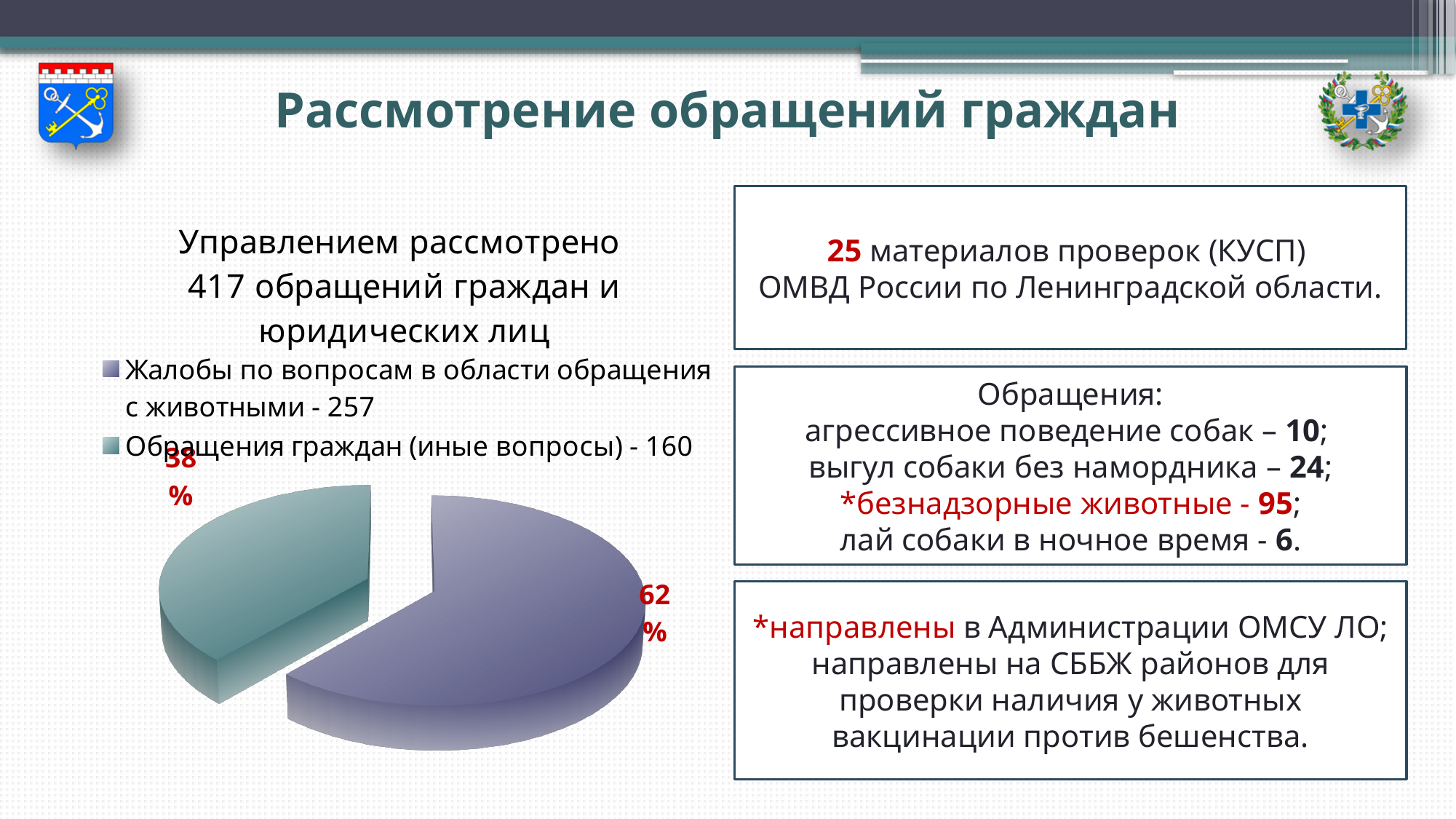
What share of the pie does "Жалобы по вопросам в области обращения с животными" take? 62% What share of the pie does "Обращения граждан (иные вопросы)" take? 38% Which slice of the pie chart is the smallest? Обращения граждан (иные вопросы) Which slice of the pie chart is the largest? Жалобы по вопросам в области обращения с животными According to the legend, how many "Жалобы по вопросам в области обращения с животными" were there? 257 According to the legend, how many "Обращения граждан (иные вопросы)" were there? 160 How many slices does the pie chart have? 2 Which is larger: the share for "Жалобы по вопросам в области обращения с животными" or the share for "Обращения граждан (иные вопросы)"? Жалобы по вопросам в области обращения с животными What is the title of the pie chart? Управлением рассмотрено 417 обращений граждан и юридических лиц By how many percentage points does the share of "Жалобы по вопросам в области обращения с животными" exceed the share of "Обращения граждан (иные вопросы)"? 24 How many entries does the legend of the pie chart list? 2 What kind of chart is shown on the slide? pie chart